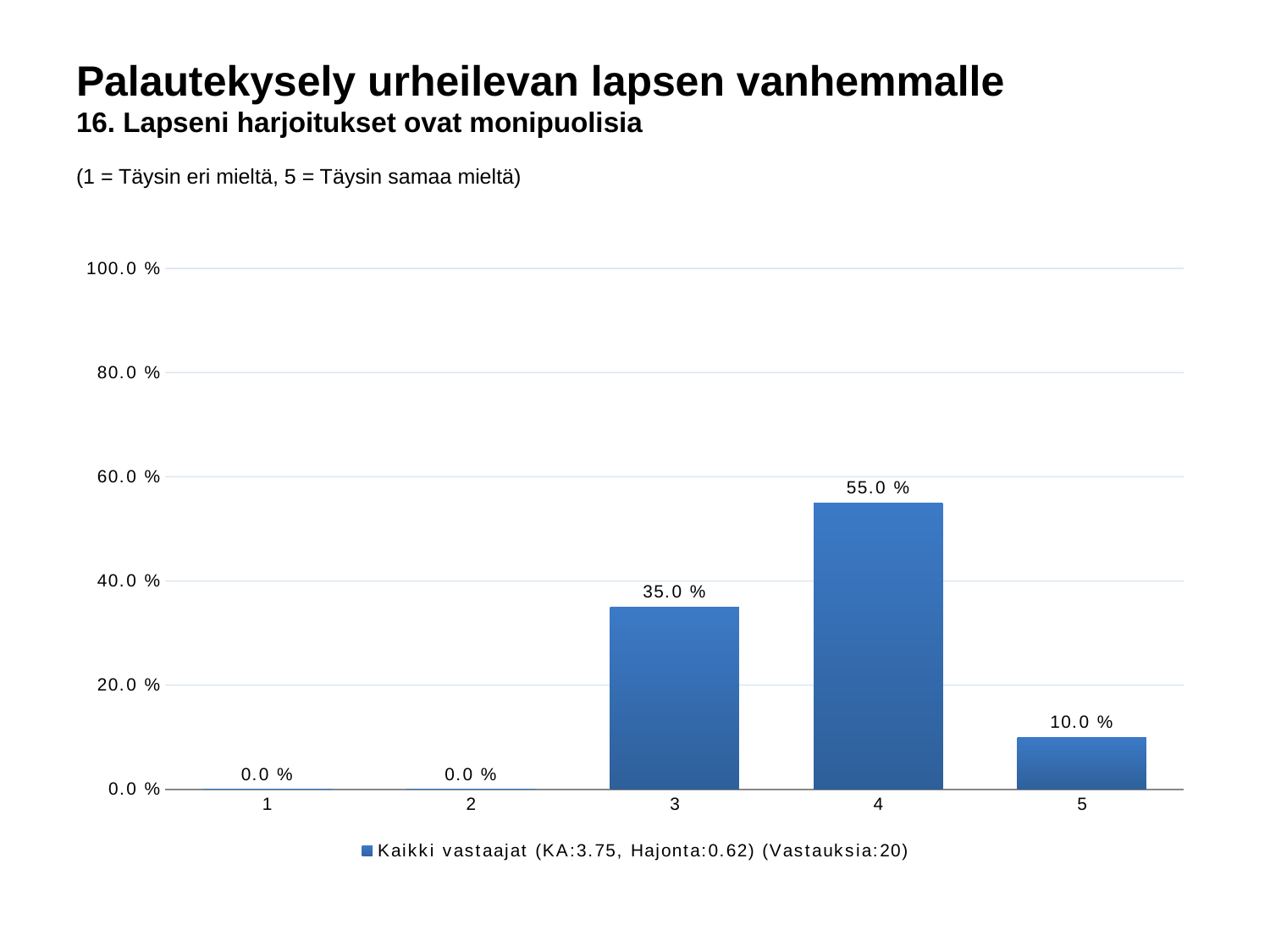
Which is larger, the value for category 3 or the value for category 5? 3 What is the difference between the values for categories 4 and 3? 20.0 % What is the value for category 4? 55.0 % Is the value for category 4 greater or less than 40.0 %? greater Which category has the highest value? 4 How many series does the legend list? 1 What kind of chart is shown? bar chart What is the number of responses (Vastauksia) given in the legend? 20 What is the value for category 3? 35.0 % What is the value for category 5? 10.0 % How many categories are shown on the x axis? 5 What is the value for category 1? 0.0 %